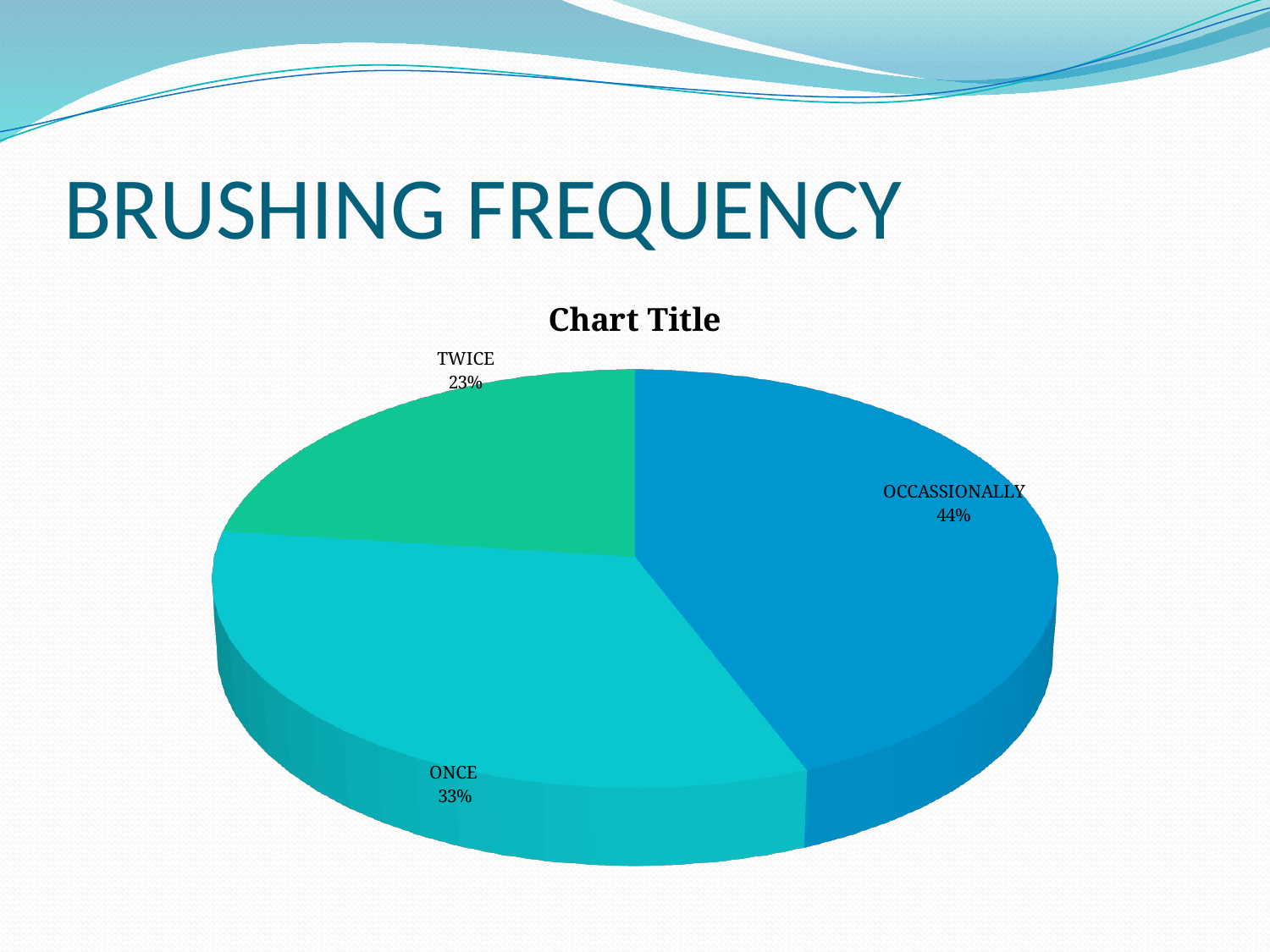
What is the title of the slide? BRUSHING FREQUENCY What percentage of the pie is labelled OCCASSIONALLY? 44% What is the difference in percentage points between the ONCE and TWICE slices? 10 Which category has the largest share of the pie? OCCASSIONALLY How many slices does the pie chart have? 3 Which category has the smallest share of the pie? TWICE What is the title printed above the pie chart? Chart Title What percentage of the pie is labelled ONCE? 33% What is the difference in percentage points between the OCCASSIONALLY and TWICE slices? 21 What percentage of the pie is labelled TWICE? 23% Which slice is larger, ONCE or TWICE? ONCE What kind of chart is shown on the slide? Pie chart